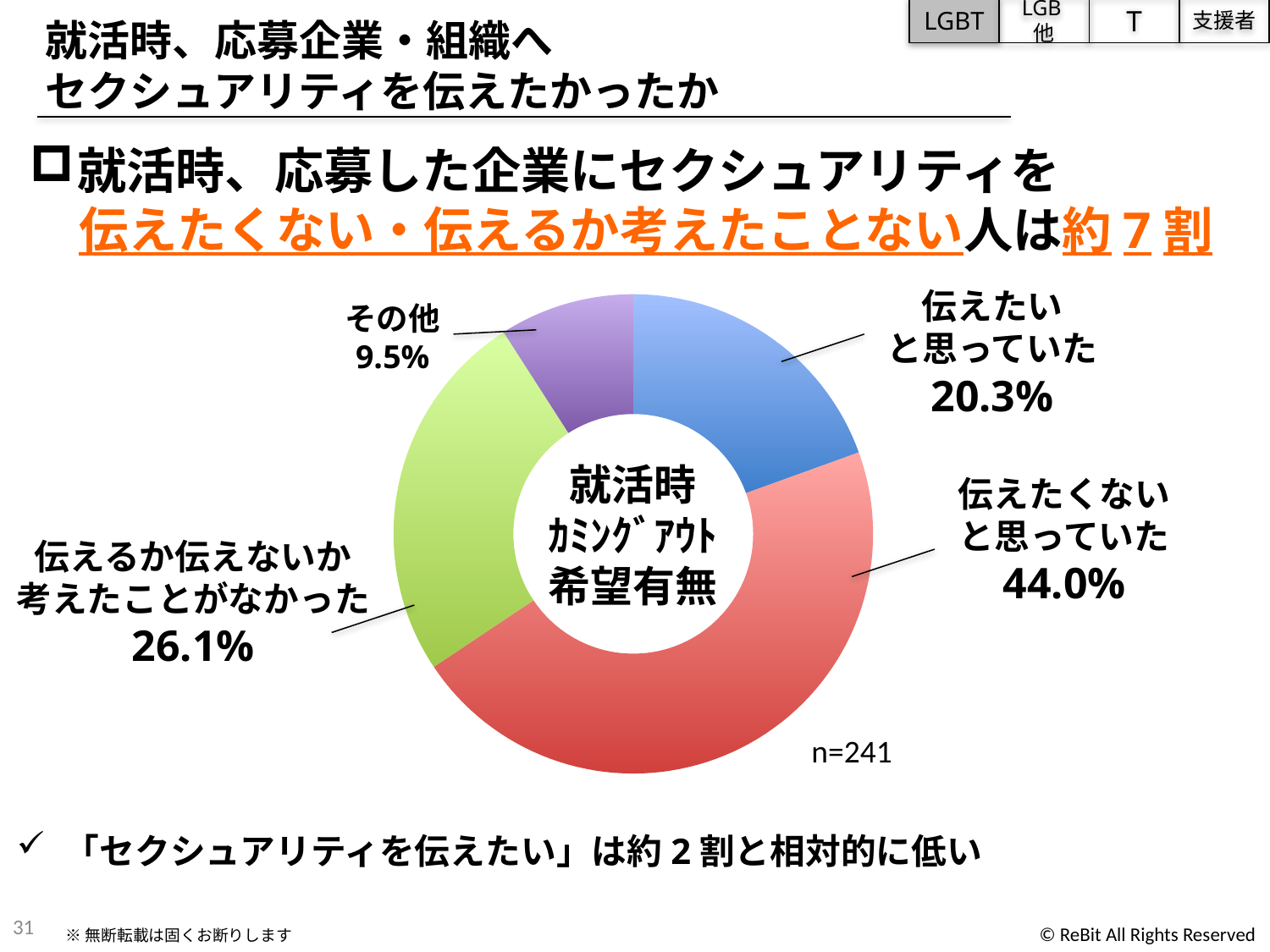
What is the share for 「その他」? 9.5% What is the share for 「伝えるか伝えないか考えたことがなかった」? 26.1% What is the combined share of 「伝えたくないと思っていた」 and 「伝えるか伝えないか考えたことがなかった」? 70.1% What kind of chart is shown on the slide? Pie (donut) chart How many categories are shown in the chart? 4 Which category has the smallest share in the chart? その他 What is the difference in percentage points between 「伝えたくないと思っていた」 and 「伝えたいと思っていた」? 23.7 Which is larger: the share for 「伝えるか伝えないか考えたことがなかった」 or the share for 「伝えたいと思っていた」? 伝えるか伝えないか考えたことがなかった What percentage of respondents answered 「伝えたいと思っていた」? 20.3% What is the sample size (n) shown next to the chart? n=241 What percentage of respondents answered 「伝えたくないと思っていた」 in the donut chart? 44.0% Which category has the largest share in the chart? 伝えたくないと思っていた